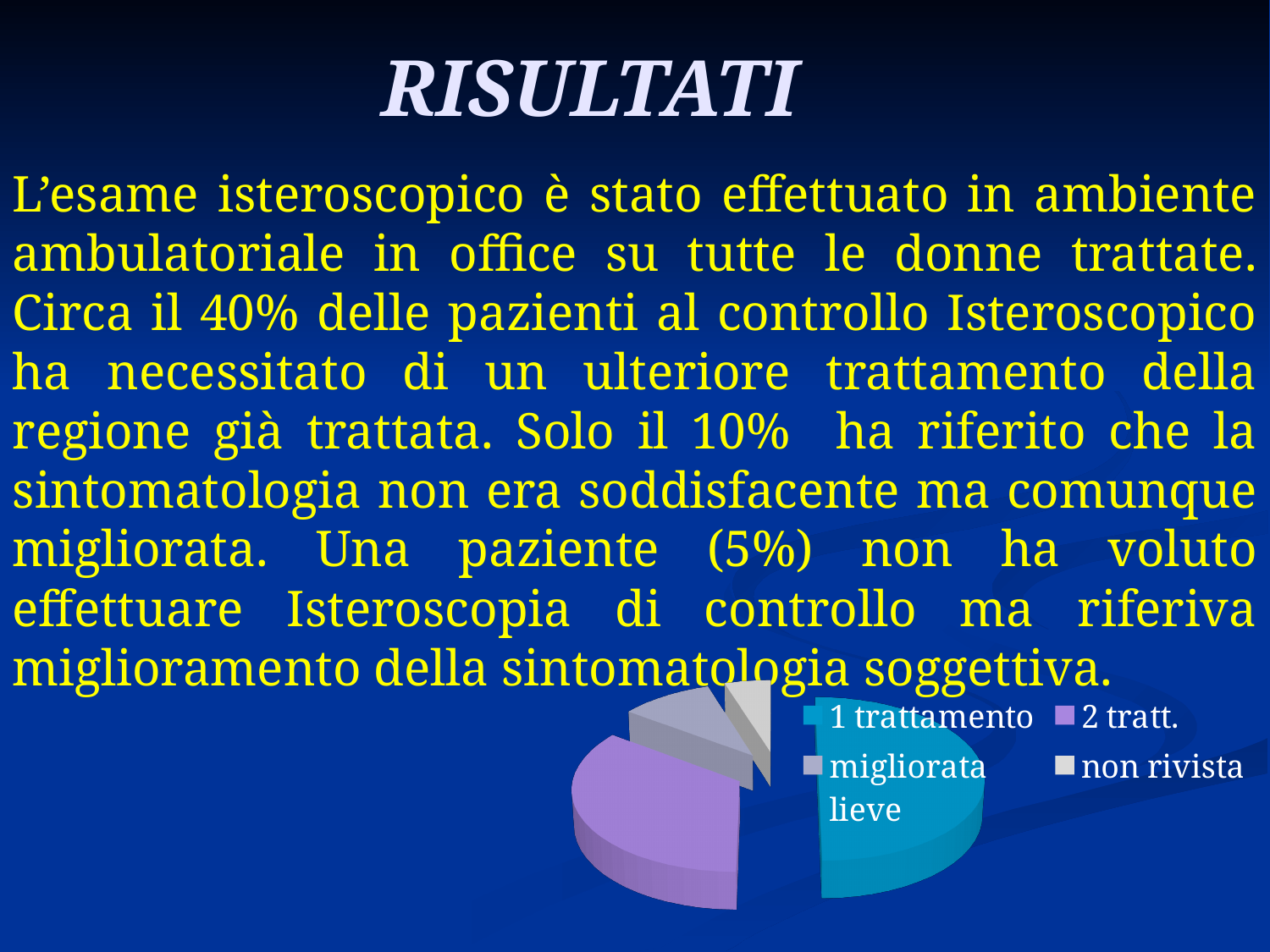
Which slice is larger in the pie chart, "2 tratt." or "migliorata lieve"? 2 tratt. Which slice is larger in the pie chart, "1 trattamento" or "non rivista"? 1 trattamento Which category has the smallest slice in the pie chart? non rivista What colour is the "2 tratt." slice in the pie chart? purple Which slice is larger in the pie chart, "migliorata lieve" or "non rivista"? migliorata lieve How many entries does the legend of the pie chart list? 4 What kind of chart is shown on the slide? pie chart What is the first entry listed in the legend of the pie chart? 1 trattamento How many slices does the pie chart have? 4